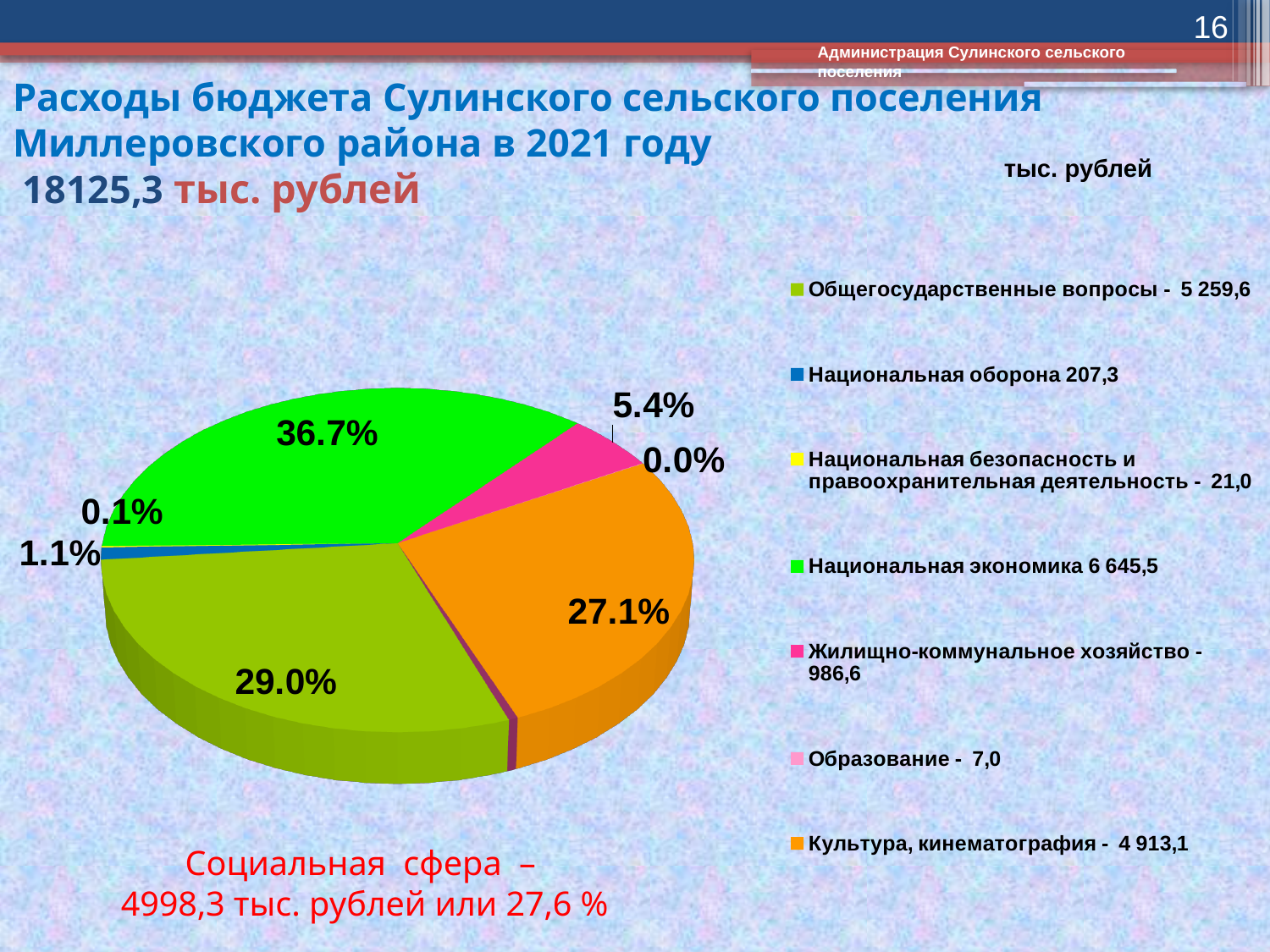
What kind of chart is shown on the slide? pie chart What is the difference between the legend values for Национальная экономика and Общегосударственные вопросы? 1 385,9 What value does the legend give for Культура, кинематография? 4 913,1 How many categories does the legend of the pie chart list? 7 What value does the legend give for Жилищно-коммунальное хозяйство? 986,6 What share of the pie does Национальная экономика take? 36.7% What total amount in тыс. рублей is stated in the slide title? 18125,3 What value does the legend give for Национальная экономика? 6 645,5 Which is larger: Общегосударственные вопросы or Культура, кинематография? Общегосударственные вопросы Which category has the smallest value in the legend? Образование What share of the pie does Общегосударственные вопросы take? 29.0% Which category has the largest slice of the pie? Национальная экономика